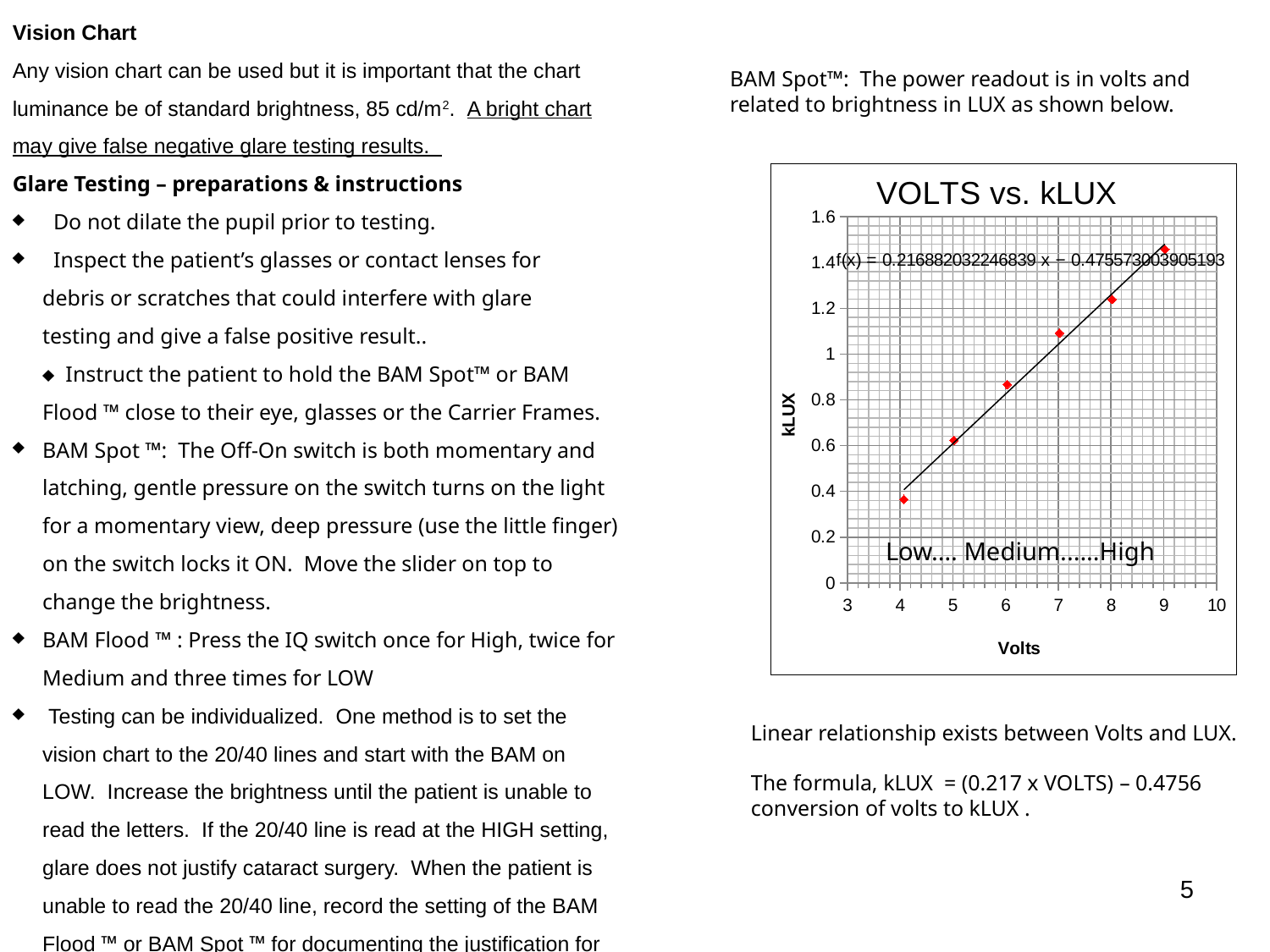
What is the label of the vertical axis of the chart? kLUX Which has the larger kLUX value, the point at 8 volts or the point at 5 volts? 8 volts Is the kLUX value at 8 volts greater or less than 1? greater Is the kLUX value at 4 volts greater or less than 0.6? less At which Volts value is the plotted kLUX highest? 9 Is the kLUX value at 9 volts greater or less than 1.2? greater What is the title of the chart? VOLTS vs. kLUX What kind of chart is shown on the slide? scatter chart At which Volts value is the plotted kLUX lowest? 4 How many data points are plotted on the chart? 6 Do the kLUX values rise or fall as Volts increase along the x axis? rise